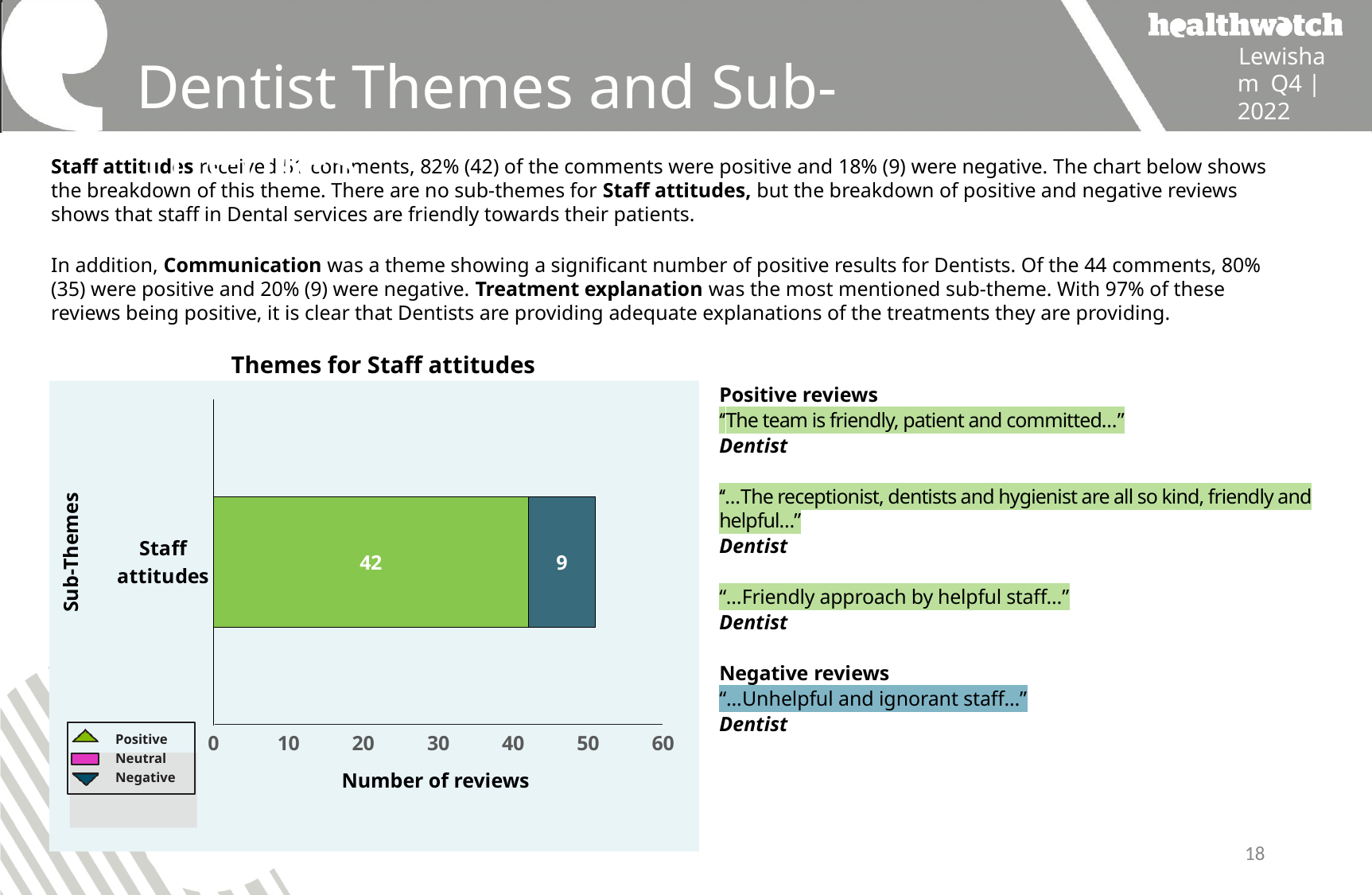
What is the difference between the positive and negative review counts for Staff attitudes? 33 How many categories are plotted on the y axis of the chart? 1 What is the label of the x axis of the chart? Number of reviews What is the title of the chart? Themes for Staff attitudes Is the negative review count for Staff attitudes greater or less than 10? less What is the number of positive reviews for Staff attitudes in the chart? 42 How many series does the chart legend list? 3 Which series has the larger value for Staff attitudes, Positive or Negative? Positive What is the total number of reviews shown in the stacked bar for Staff attitudes? 51 What kind of chart is shown on the slide? Stacked bar chart Is the positive review count for Staff attitudes greater or less than 40? greater What is the number of negative reviews for Staff attitudes in the chart? 9